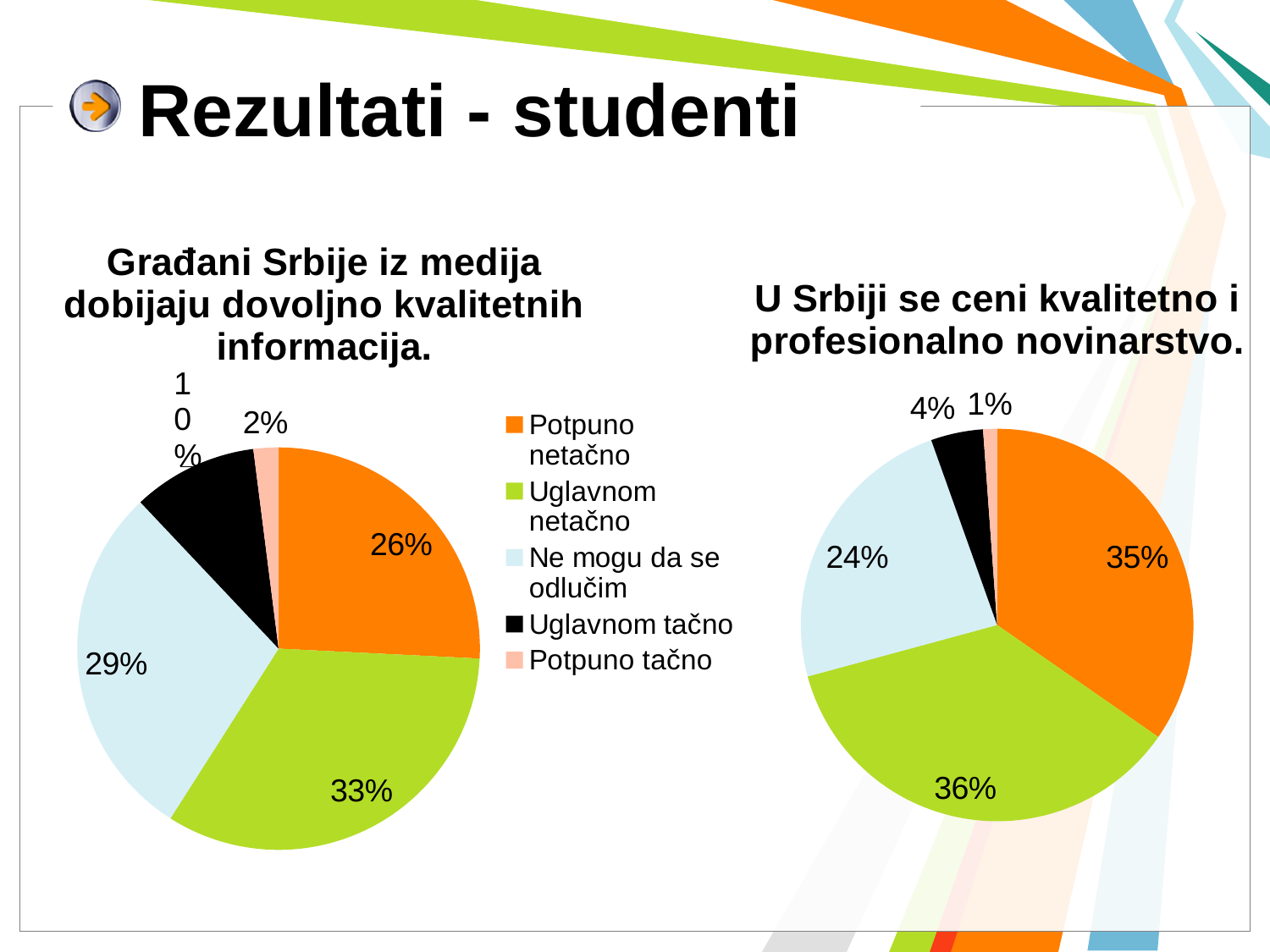
In the right pie chart (U Srbiji se ceni kvalitetno i profesionalno novinarstvo), what share is labelled for Ne mogu da se odlučim? 24% In the right pie chart (U Srbiji se ceni kvalitetno i profesionalno novinarstvo), what is the combined share of Potpuno netačno and Uglavnom netačno? 71% How many categories does the legend list for the pie charts? 5 In the right pie chart (U Srbiji se ceni kvalitetno i profesionalno novinarstvo), what share is labelled for Uglavnom tačno? 4% In the right pie chart (U Srbiji se ceni kvalitetno i profesionalno novinarstvo), which is larger: the share for Potpuno netačno or the share for Ne mogu da se odlučim? Potpuno netačno In the left pie chart (Građani Srbije iz medija dobijaju dovoljno kvalitetnih informacija), what is the difference between the shares for Uglavnom netačno and Potpuno netačno? 7% In the left pie chart (Građani Srbije iz medija dobijaju dovoljno kvalitetnih informacija), what share is labelled for Uglavnom netačno? 33% Which colour represents Ne mogu da se odlučim in the pie charts? Light blue What type of chart is used for U Srbiji se ceni kvalitetno i profesionalno novinarstvo? Pie chart In the left pie chart (Građani Srbije iz medija dobijaju dovoljno kvalitetnih informacija), what share is labelled for Potpuno tačno? 2% In the left pie chart (Građani Srbije iz medija dobijaju dovoljno kvalitetnih informacija), which category has the largest share? Uglavnom netačno In the right pie chart (U Srbiji se ceni kvalitetno i profesionalno novinarstvo), which category has the smallest share? Potpuno tačno